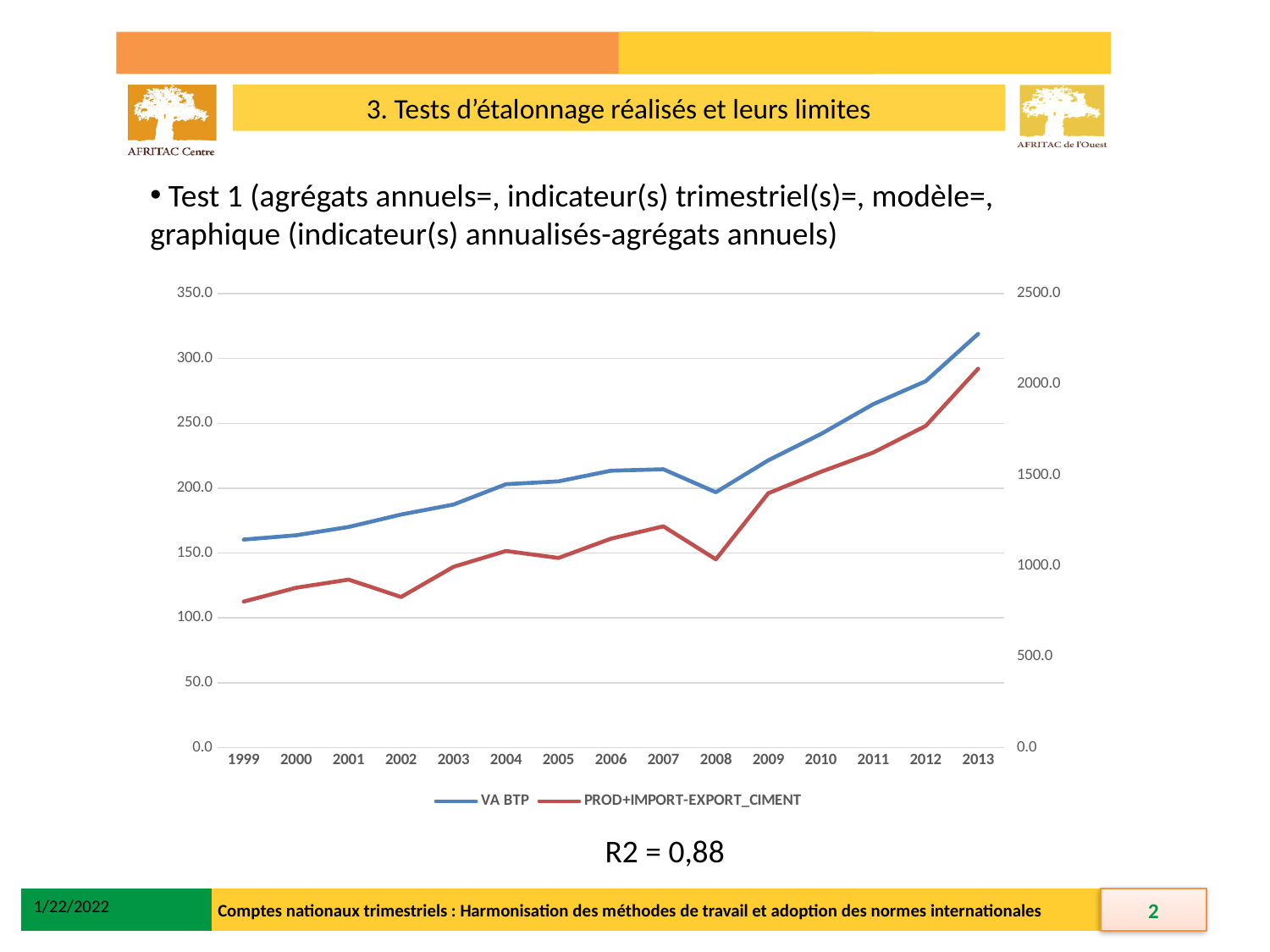
What kind of chart is shown on the slide? Line chart Between 2007 and 2008, does the PROD+IMPORT-EXPORT_CIMENT series rise or fall? Fall How many years are shown on the x axis of the chart? 15 What is the last year shown on the x axis of the chart? 2013 In which year does the VA BTP series have its lowest value? 1999 How many series does the chart legend list? 2 In which year does the PROD+IMPORT-EXPORT_CIMENT series reach its highest value? 2013 In which year does the PROD+IMPORT-EXPORT_CIMENT series have its lowest value? 1999 Between 2001 and 2002, does the PROD+IMPORT-EXPORT_CIMENT series rise or fall? Fall What is the first year shown on the x axis of the chart? 1999 Does the VA BTP series generally rise or fall from 1999 to 2013? Rise In which year does the VA BTP series reach its highest value? 2013